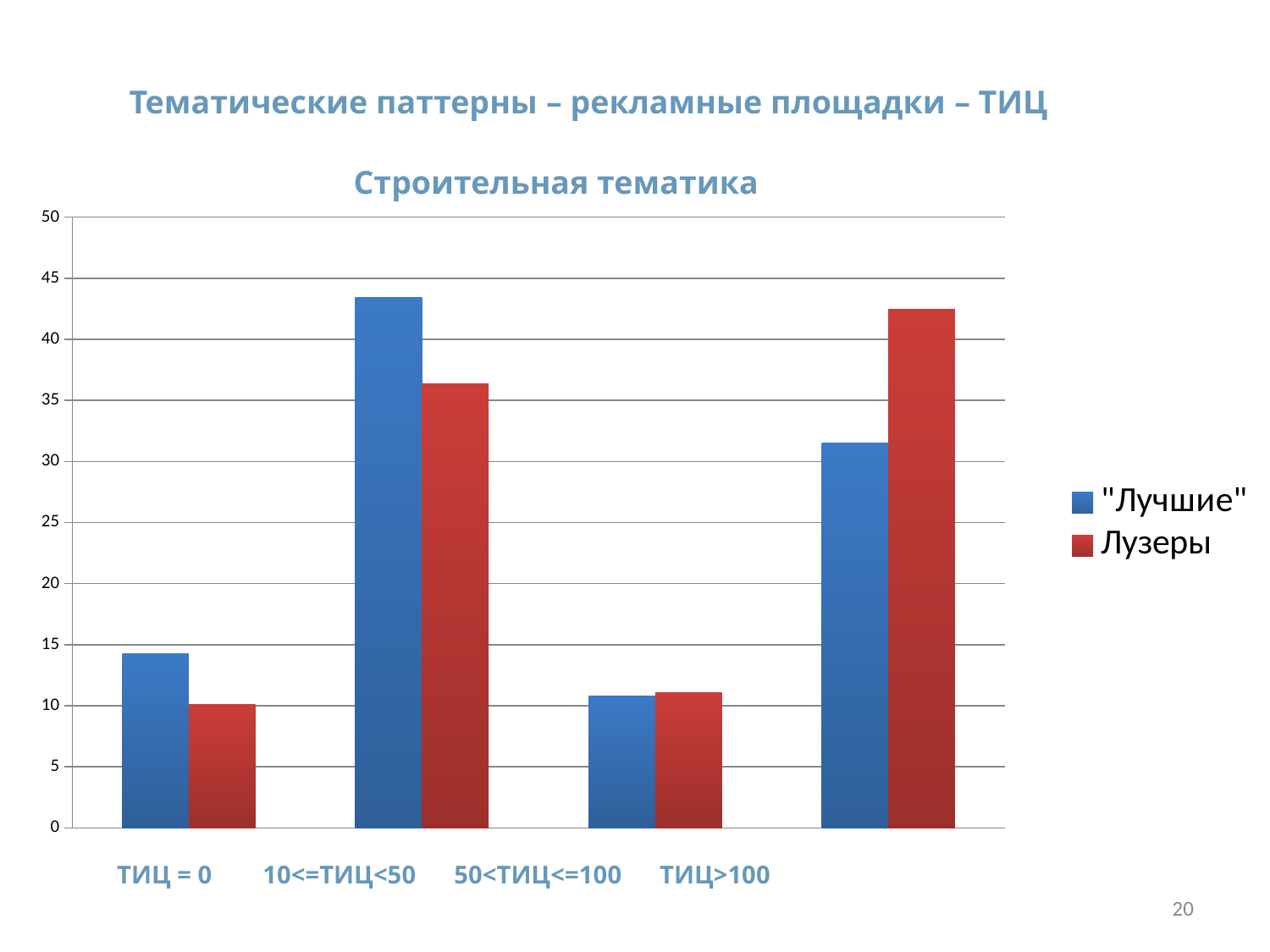
For the "Лучшие" series, which category has the lowest value? 50<ТИЦ<=100 For the "Лузеры" series, which category has the highest value? ТИЦ>100 Which colour represents the "Лузеры" series? red How many categories are shown on the x axis? 4 Is the value for "Лучшие" in the 10<=ТИЦ<50 category greater or less than 40? greater Is the value for Лузеры in the ТИЦ = 0 category greater or less than 15? less What is the title of the chart? Строительная тематика What kind of chart is shown on the slide? bar chart How many series does the legend list? 2 In the 10<=ТИЦ<50 category, which series has the larger value, "Лучшие" or Лузеры? "Лучшие" In the ТИЦ>100 category, which series has the larger value, "Лучшие" or Лузеры? Лузеры For the "Лучшие" series, which category has the highest value? 10<=ТИЦ<50